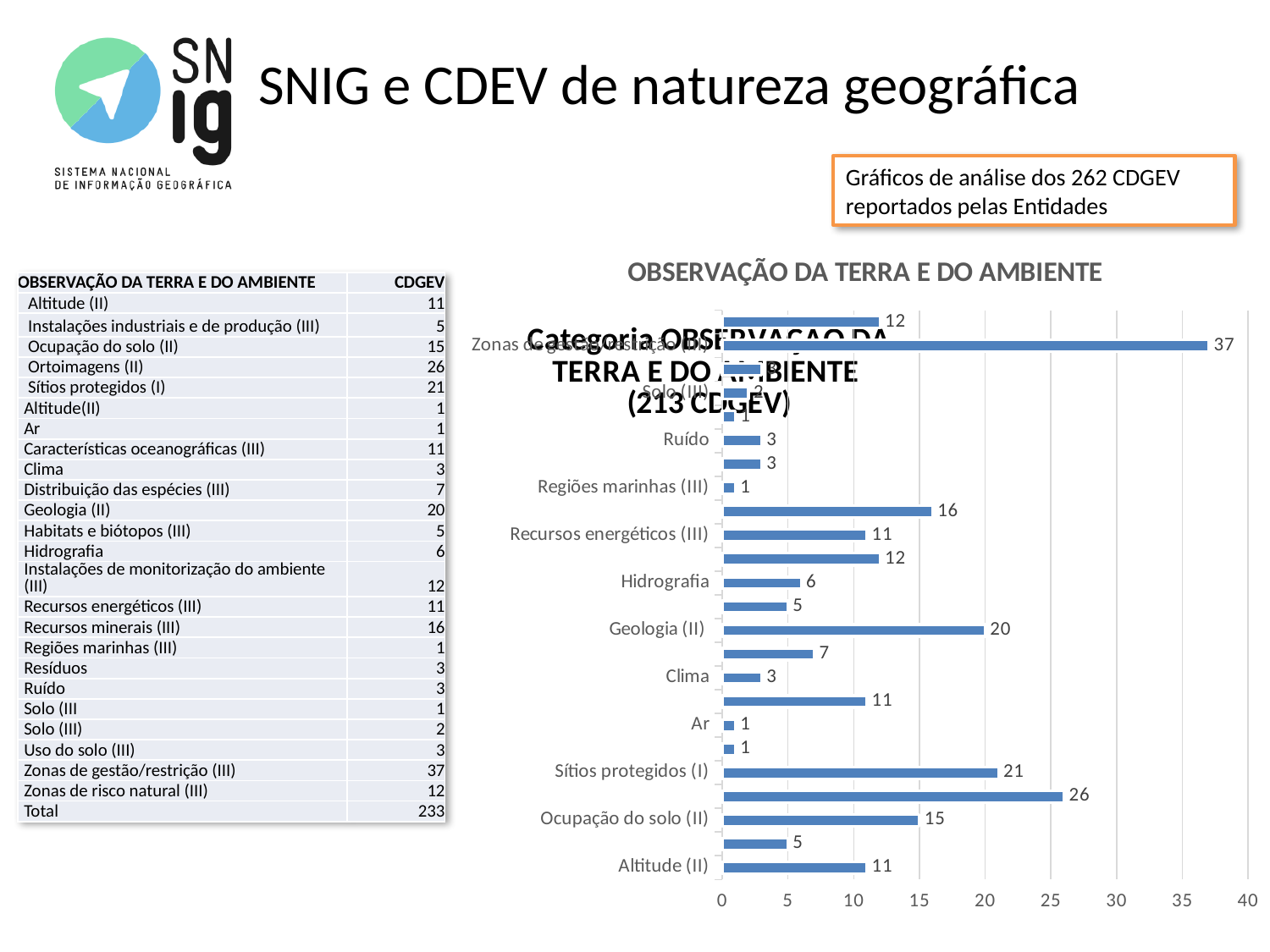
Which has a larger value, Ocupação do solo (II) or Hidrografia? Ocupação do solo (II) What is the title of the chart? OBSERVAÇÃO DA TERRA E DO AMBIENTE What is the difference between the values for Geologia (II) and Hidrografia? 14 What is the value for Sítios protegidos (I) in the chart? 21 What is the highest value shown by any bar in the chart? 37 What is the value for Ocupação do solo (II) in the chart? 15 What is the value for Altitude (II) in the chart? 11 What is the value for Hidrografia in the chart? 6 Is the value for Geologia (II) greater or less than 15? greater What is the value for Geologia (II) in the chart? 20 What is the value for Recursos energéticos (III) in the chart? 11 What type of chart is shown on the slide? bar chart